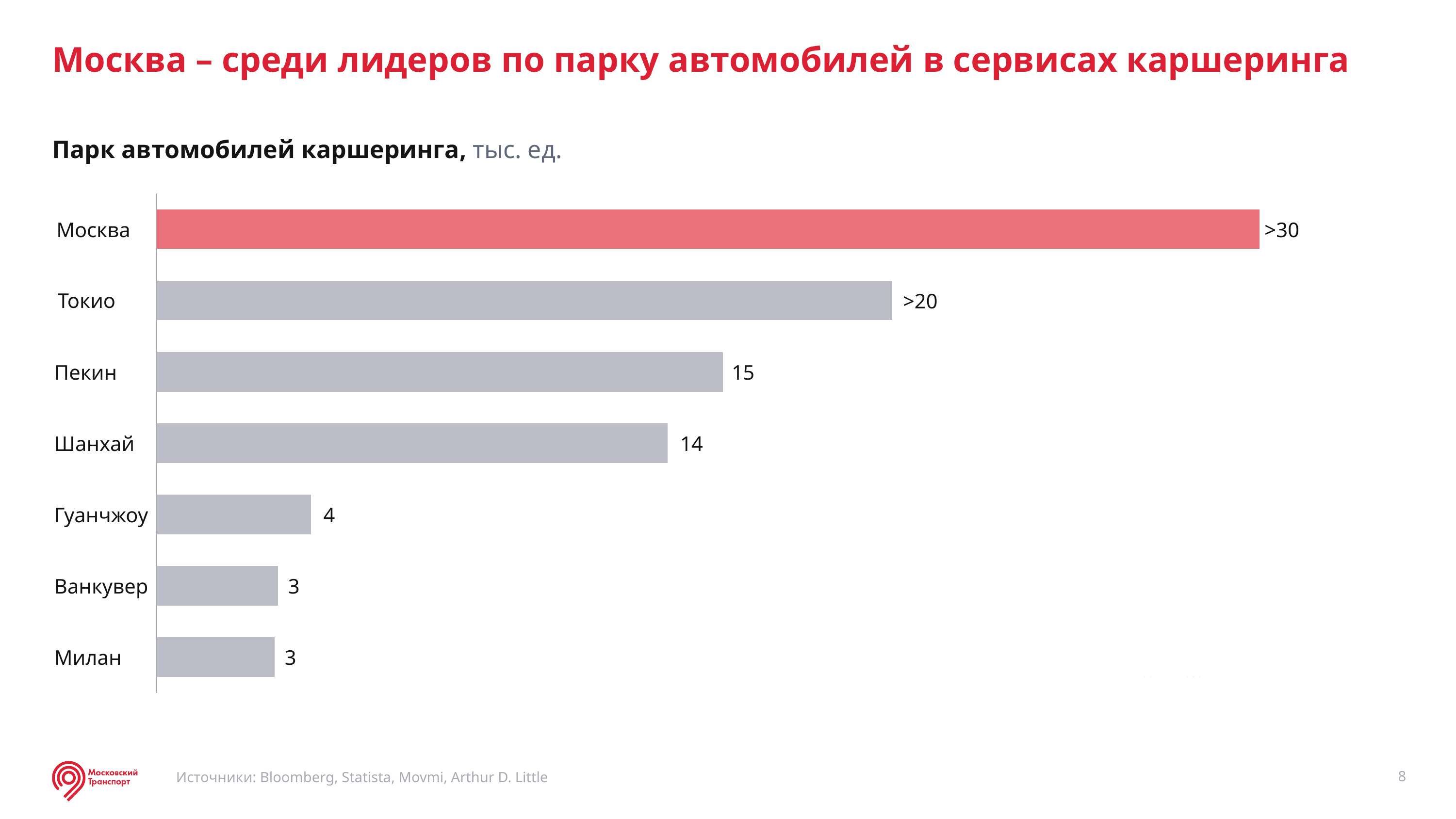
Which city has the highest value in the chart? Москва What kind of chart is shown on the slide? Bar chart What is the data label shown for Токио? >20 What is the value shown for Шанхай? 14 What is the value shown for Гуанчжоу? 4 What is the data label shown for Москва? >30 Which has a larger value, Пекин or Гуанчжоу? Пекин How many cities are shown in the chart? 7 What is the difference between the values for Шанхай and Ванкувер? 11 What unit is given in the chart title? тыс. ед. What is the value shown for Пекин? 15 What is the difference between the values for Пекин and Шанхай? 1